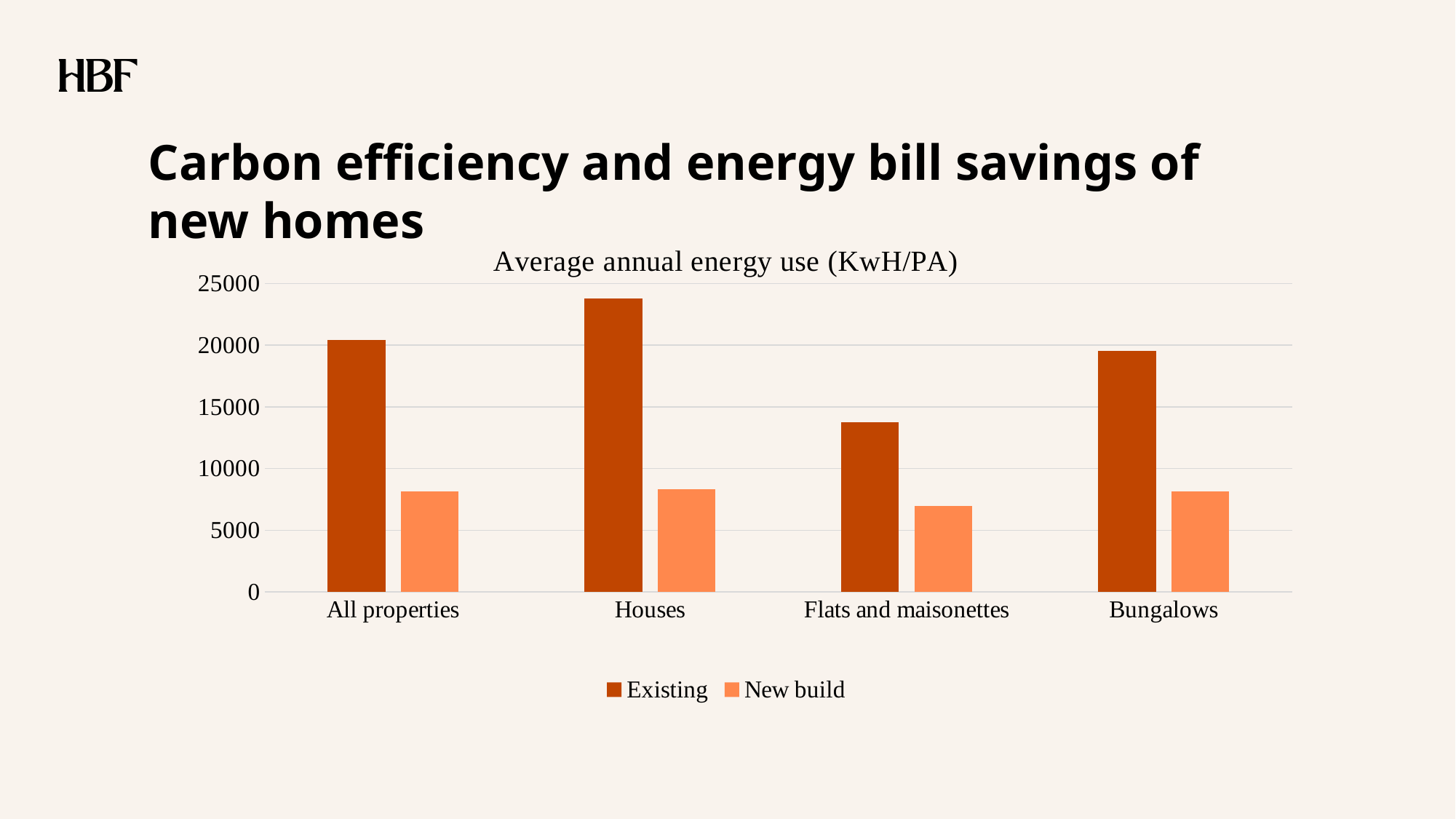
Is the Existing value for Flats and maisonettes greater or less than 15000? less Is the New build value for All properties greater or less than 10000? less Which category has the highest Existing value? Houses Which category has the lowest New build value? Flats and maisonettes How many property categories are shown on the x axis? 4 How many series does the legend list? 2 Which category has the lowest Existing value? Flats and maisonettes What is the title of the chart? Average annual energy use (KwH/PA) What are the two series named in the legend? Existing and New build What kind of chart is shown on the slide? Bar chart For Houses, which is larger: the Existing value or the New build value? Existing Is the Existing value for Houses greater or less than 20000? greater